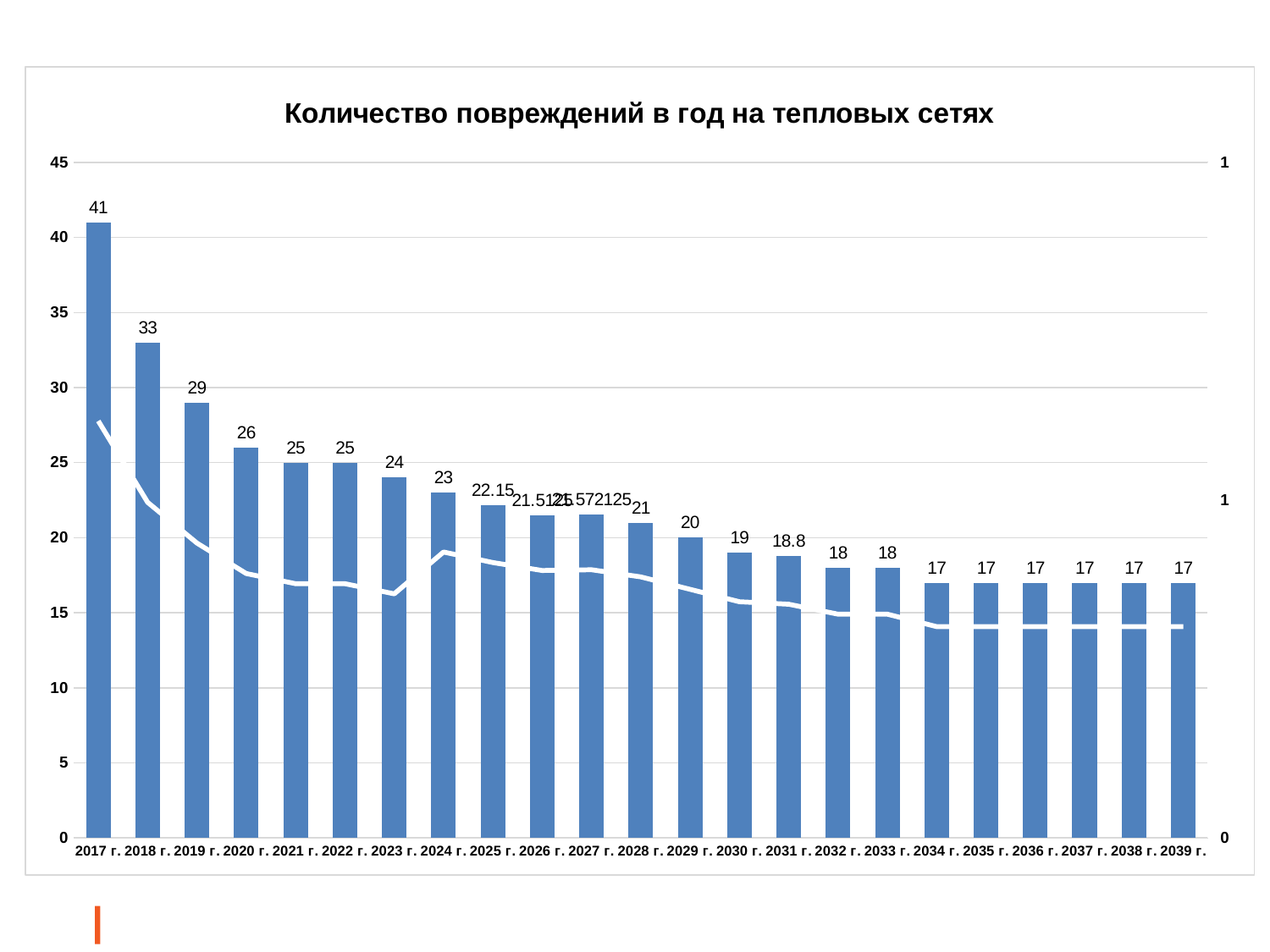
What is the value for 2025 г.? 22.15 Which is larger, the value for 2019 г. or the value for 2020 г.? 2019 г. What is the difference between the values for 2017 г. and 2018 г.? 8 What is the title of the chart? Количество повреждений в год на тепловых сетях What is the value for 2017 г.? 41 What is the value for 2031 г.? 18.8 What kind of chart is shown on the slide? combination bar and line chart Which year has the highest value? 2017 г. What is the lowest value shown on the bars? 17 Do the bar values rise or fall from 2017 г. to 2039 г.? fall What is the value for 2018 г.? 33 What is the value for 2039 г.? 17